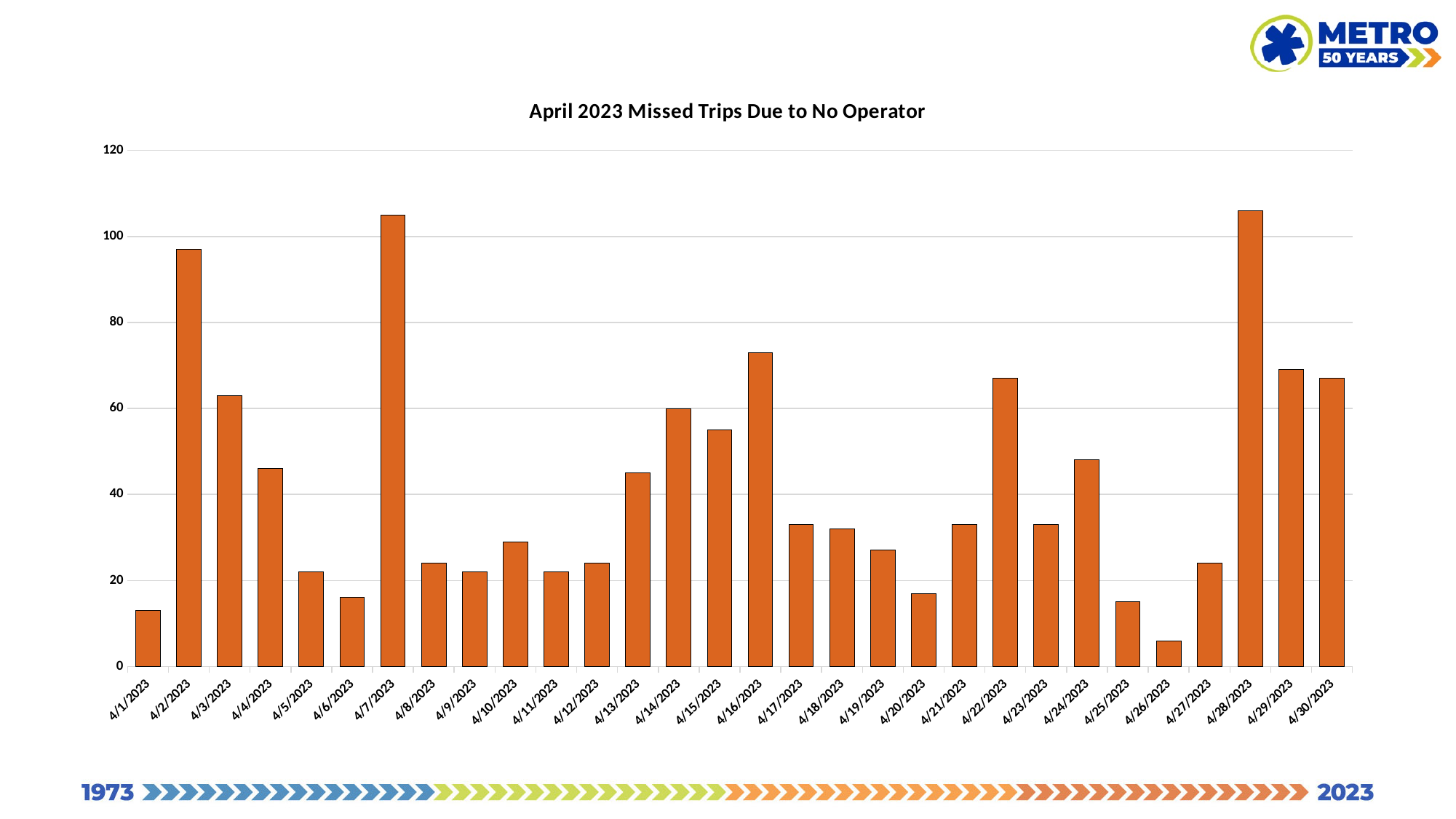
Is the value for 4/26/2023 greater or less than 20? less What type of chart is shown on the slide? bar chart Do the values rise or fall from 4/12/2023 to 4/16/2023? rise How many dates (bars) are plotted on the chart? 30 Is the value for 4/2/2023 greater or less than 80? greater Is the value for 4/1/2023 greater or less than 20? less Which date has the lowest number of missed trips? 4/26/2023 Which has more missed trips, 4/13/2023 or 4/14/2023? 4/14/2023 What is the title of the chart? April 2023 Missed Trips Due to No Operator Which has more missed trips, 4/2/2023 or 4/3/2023? 4/2/2023